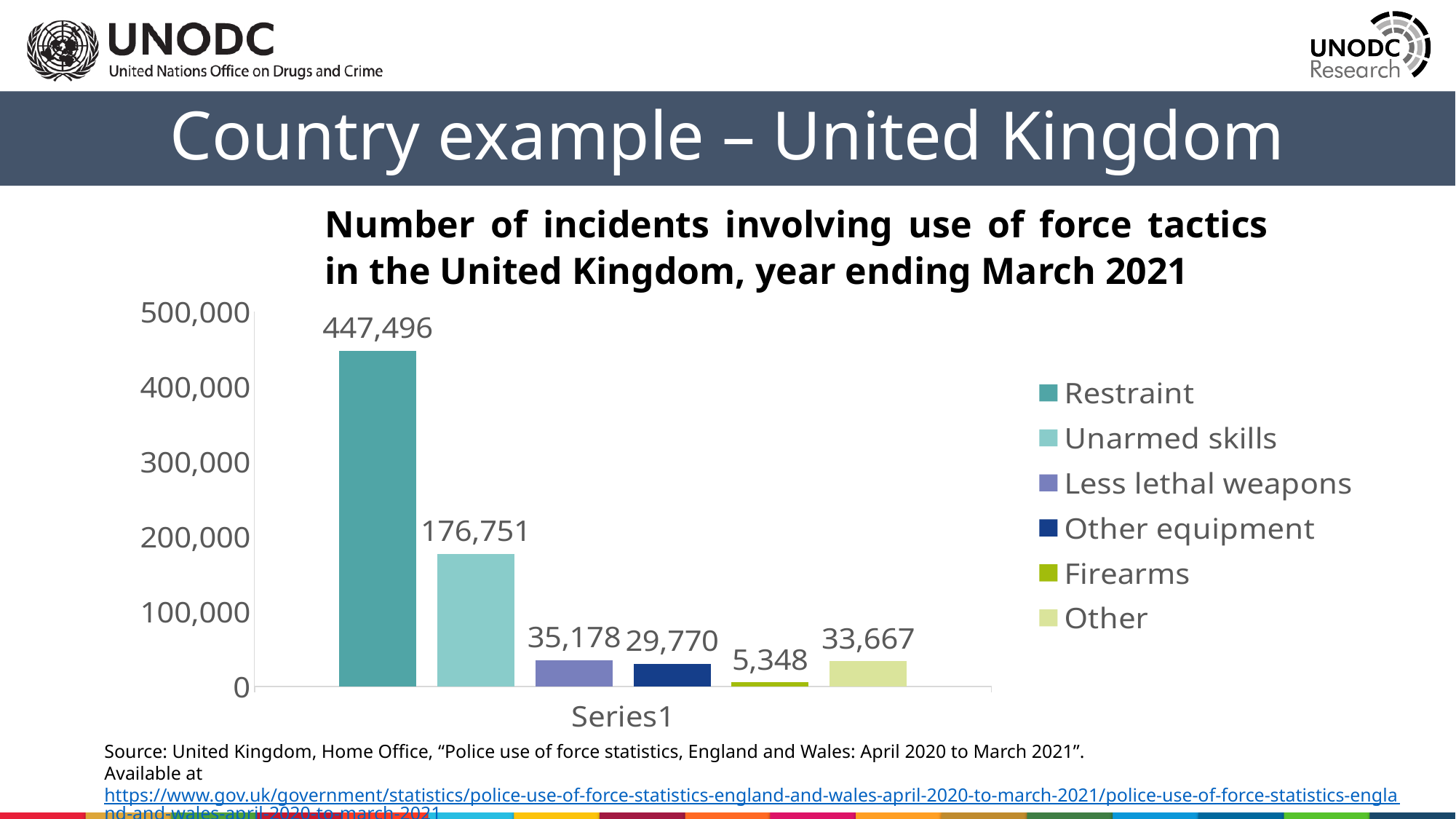
What is the difference between the number of incidents for Restraint and for Unarmed skills? 270,745 What is the number of incidents for Other equipment? 29,770 What is the number of incidents for Restraint? 447,496 Which use of force tactic has the lowest number of incidents? Firearms What is the difference between the number of incidents for Less lethal weapons and for Other equipment? 5,408 How many series does the legend list? 6 Which use of force tactic has the highest number of incidents? Restraint What is the number of incidents for Unarmed skills? 176,751 Which has more incidents, Other equipment or Other? Other Is the value for Unarmed skills greater or less than 200,000? less What kind of chart is shown on the slide? Bar chart What is the number of incidents for Firearms? 5,348